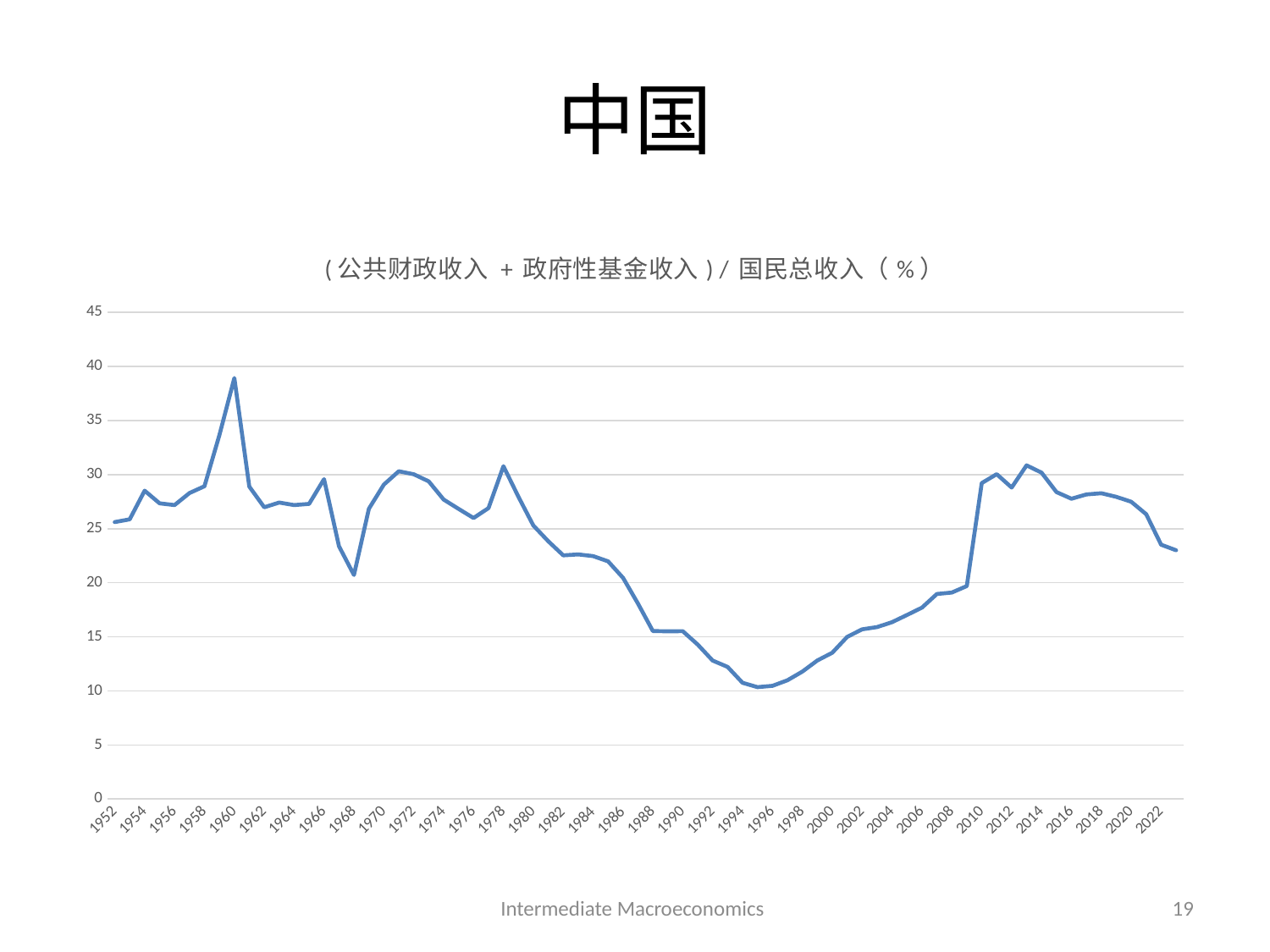
Is the value for 2010 greater or less than 25? greater Is the value for 1968 greater or less than 25? less What kind of chart is shown on the slide? line chart Is the value for 1960 greater or less than 35? greater Does the line rise or fall between 1996 and 2010? rise What is the title of the chart? （公共财政收入 + 政府性基金收入）/ 国民总收入（%） Does the line rise or fall between 1978 and 1994? fall Which year has the larger value, 1960 or 1996? 1960 In which year does the line reach its highest value? 1960